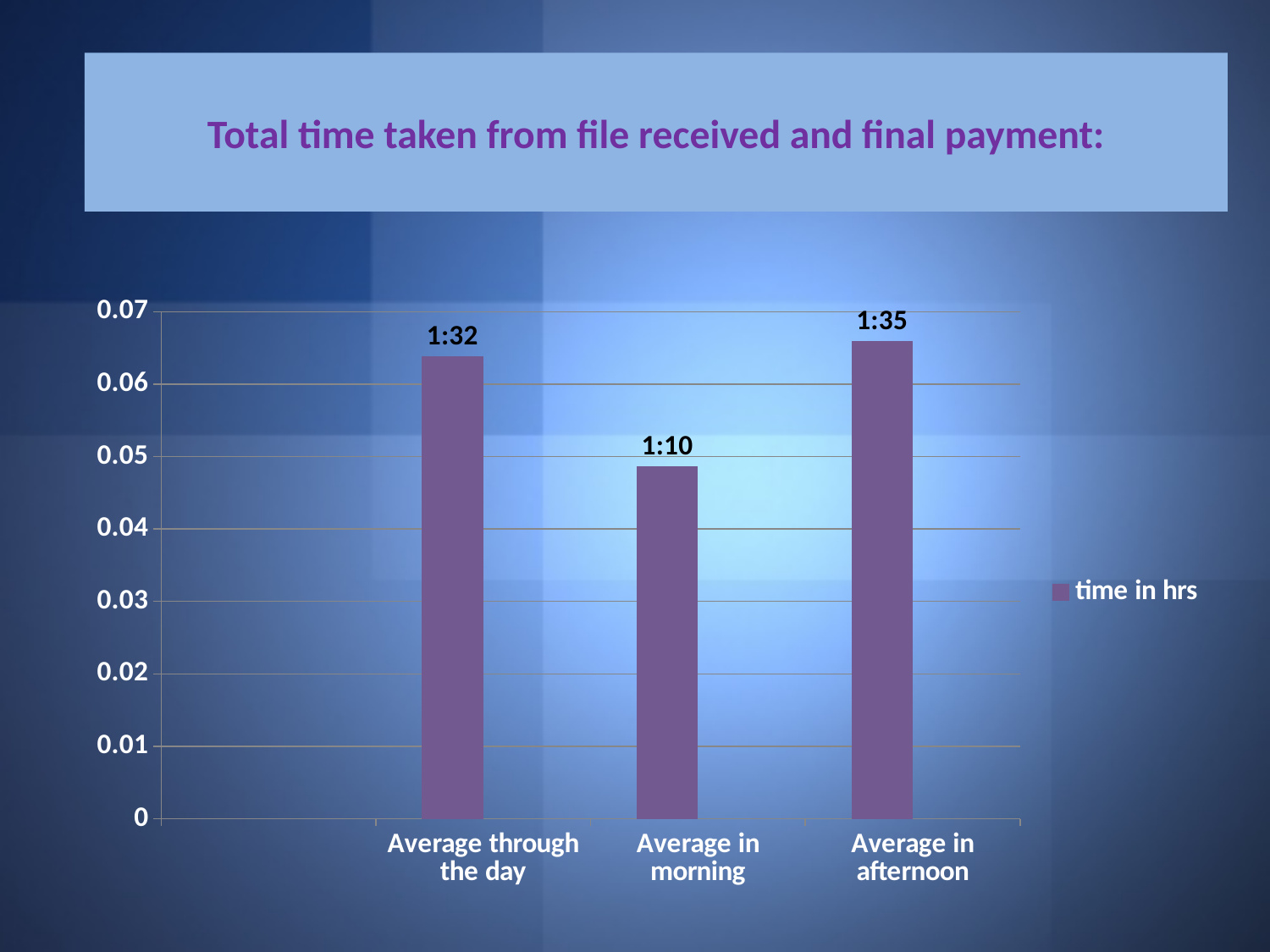
What kind of chart is shown on the slide? bar chart Is the bar for Average in morning greater or less than 0.05 on the axis? less What is the data label for Average through the day? 1:32 Is the bar for Average in afternoon greater or less than 0.06 on the axis? greater How many categories are shown on the x axis? 3 What is the legend entry for the series? time in hrs What is the data label for Average in afternoon? 1:35 How many series does the legend list? 1 What is the data label for Average in morning? 1:10 Which is larger, Average through the day or Average in morning? Average through the day Which category has the lowest value? Average in morning Which category has the highest value? Average in afternoon